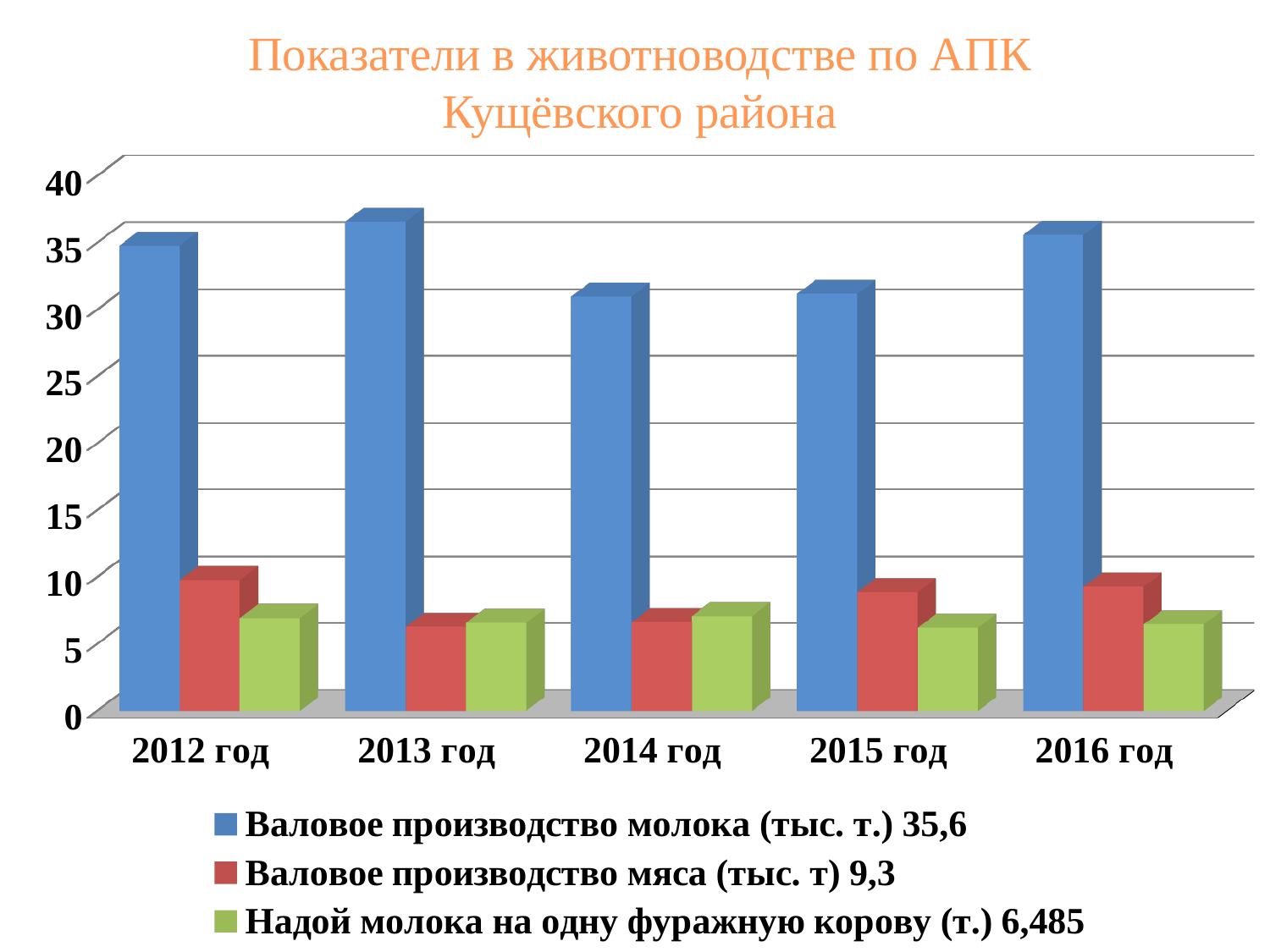
Is the value for Надой молока на одну фуражную корову in 2012 год greater or less than 5? greater Which year has the highest value for Валовое производство молока (тыс. т.)? 2013 год Is the value for Валовое производство молока in 2014 год greater or less than 35? less Is the value for Валовое производство молока in 2013 год greater or less than 35? greater What is the title of the chart? Показатели в животноводстве по АПК Кущёвского района Which year has the highest value for Валовое производство мяса (тыс. т)? 2012 год How many years (categories) are shown on the x axis? 5 Which is larger: Валовое производство мяса in 2012 год or in 2013 год? 2012 год Which is larger: Валовое производство молока in 2013 год or in 2014 год? 2013 год What kind of chart is shown on the slide? bar chart How many series does the legend list? 3